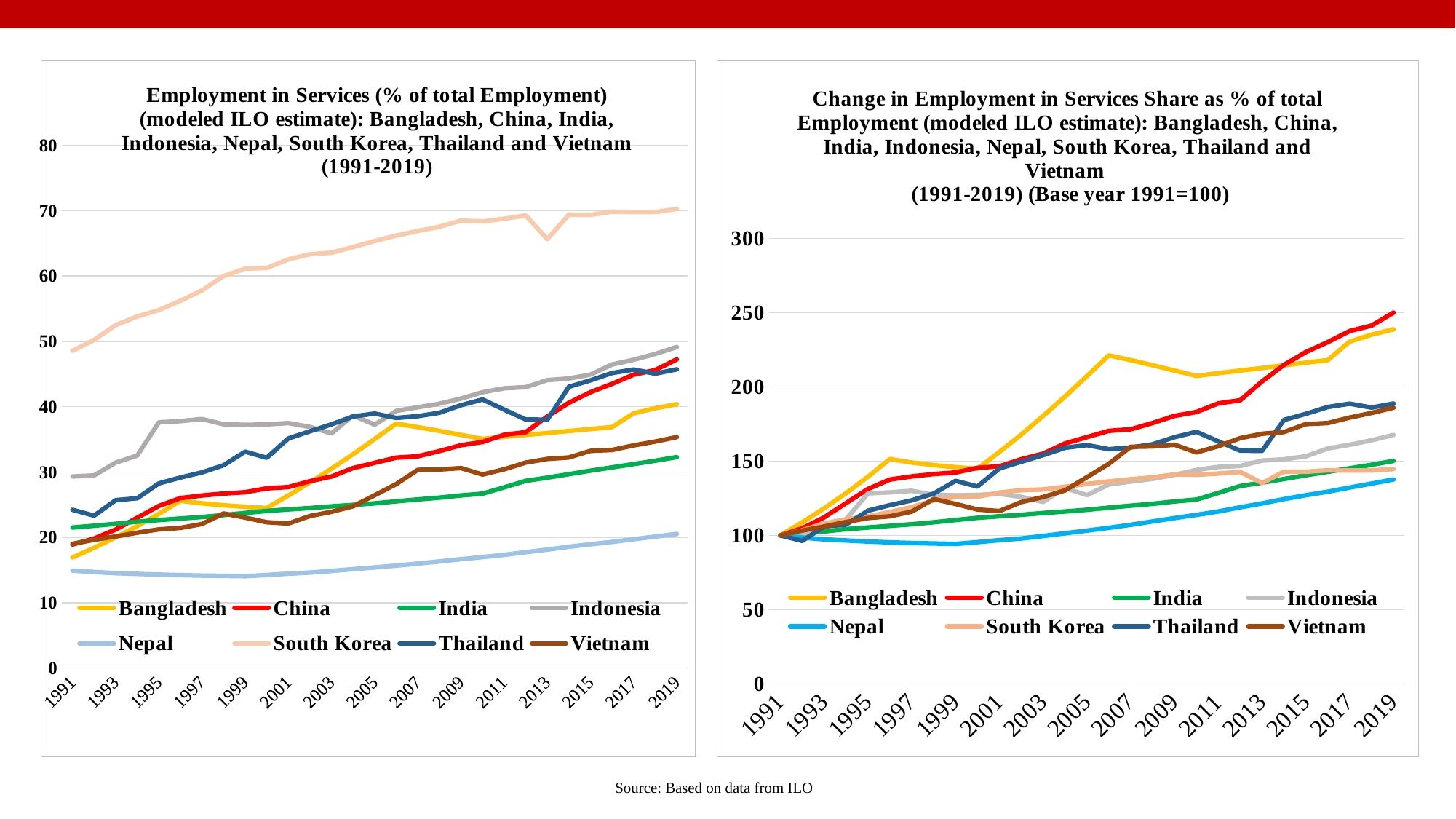
In the left chart, is the value for South Korea in 2019 greater or less than 60? greater In the right chart, which country has the highest value in 2019? China What kind of chart is the left chart, 'Employment in Services (% of total Employment)'? line chart In the right chart, is the value for Bangladesh in 2007 greater or less than 200? greater In the left chart, is the value for Nepal in 2019 greater or less than 30? less How many series does the legend of the left chart list? 8 In the left chart, which is larger in 2019, the value for China or the value for India? China In the right chart, does the value for China rise or fall from 1991 to 2019? rise What base year is used for the index in the right chart? 1991 In the left chart, which country has the highest employment in services share in 2019? South Korea In the right chart, 'Change in Employment in Services Share', what is the value for China in 1991? 100 In the left chart, which country has the lowest employment in services share in 2019? Nepal